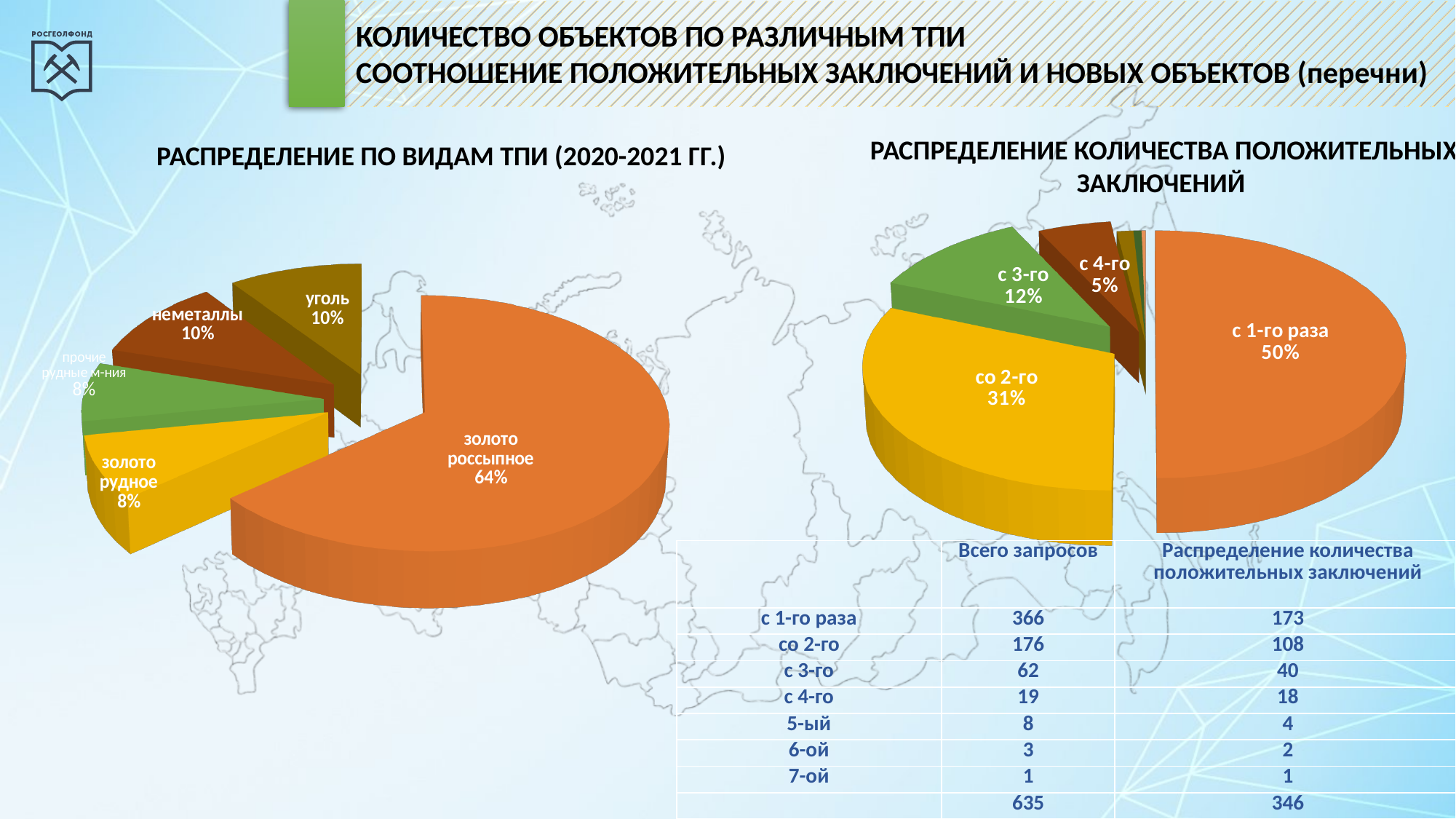
In the chart 'РАСПРЕДЕЛЕНИЕ КОЛИЧЕСТВА ПОЛОЖИТЕЛЬНЫХ ЗАКЛЮЧЕНИЙ', which is larger: 'со 2-го' or 'с 3-го'? со 2-го What kind of chart is 'РАСПРЕДЕЛЕНИЕ ПО ВИДАМ ТПИ (2020-2021 гг.)'? pie chart In the chart 'РАСПРЕДЕЛЕНИЕ КОЛИЧЕСТВА ПОЛОЖИТЕЛЬНЫХ ЗАКЛЮЧЕНИЙ', what is the difference in percentage points between 'с 1-го раза' and 'с 3-го'? 38 In the chart 'РАСПРЕДЕЛЕНИЕ ПО ВИДАМ ТПИ (2020-2021 гг.)', what is the difference in percentage points between 'золото россыпное' and 'неметаллы'? 54 In the chart 'РАСПРЕДЕЛЕНИЕ ПО ВИДАМ ТПИ (2020-2021 гг.)', how many slices does the pie have? 5 In the chart 'РАСПРЕДЕЛЕНИЕ КОЛИЧЕСТВА ПОЛОЖИТЕЛЬНЫХ ЗАКЛЮЧЕНИЙ', what share does 'со 2-го' have? 31% In the chart 'РАСПРЕДЕЛЕНИЕ ПО ВИДАМ ТПИ (2020-2021 гг.)', what share does 'уголь' have? 10% In the chart 'РАСПРЕДЕЛЕНИЕ КОЛИЧЕСТВА ПОЛОЖИТЕЛЬНЫХ ЗАКЛЮЧЕНИЙ', what share does 'с 1-го раза' have? 50% In the chart 'РАСПРЕДЕЛЕНИЕ ПО ВИДАМ ТПИ (2020-2021 гг.)', what share does 'золото рудное' have? 8% In the chart 'РАСПРЕДЕЛЕНИЕ ПО ВИДАМ ТПИ (2020-2021 гг.)', which category has the largest share? золото россыпное In the chart 'РАСПРЕДЕЛЕНИЕ КОЛИЧЕСТВА ПОЛОЖИТЕЛЬНЫХ ЗАКЛЮЧЕНИЙ', what share does 'с 4-го' have? 5% In the chart 'РАСПРЕДЕЛЕНИЕ ПО ВИДАМ ТПИ (2020-2021 гг.)', what share does 'золото россыпное' have? 64%